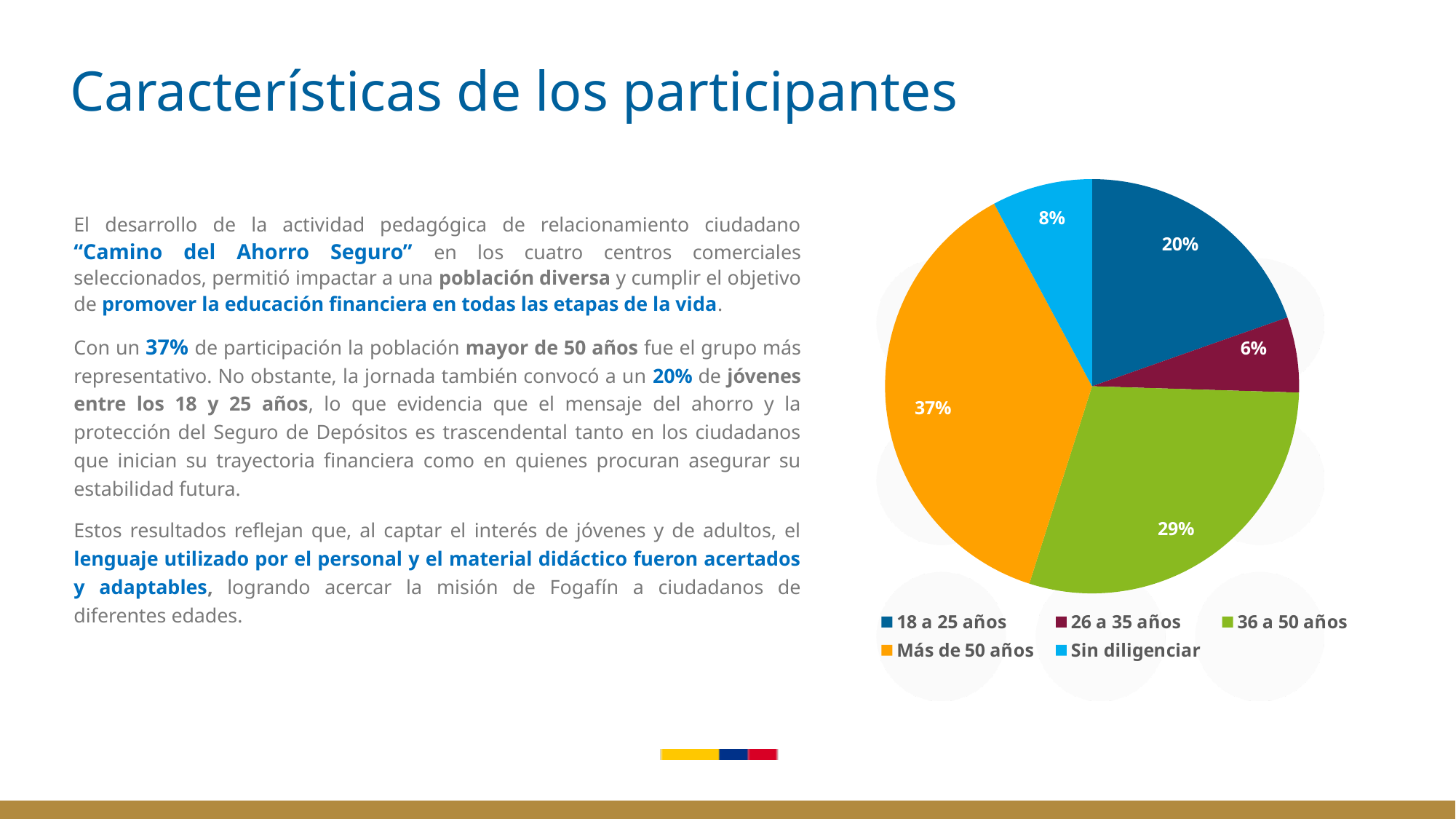
Which age group has the smallest share of the pie? 26 a 35 años What share of participants were Más de 50 años? 37% What share of participants is labelled Sin diligenciar? 8% Which slice is larger: 18 a 25 años or Sin diligenciar? 18 a 25 años How many slices does the pie chart have? 5 What share of participants were aged 36 a 50 años? 29% What colour is the slice for Más de 50 años? orange What is the difference in percentage points between the Más de 50 años slice and the 36 a 50 años slice? 8 What share of participants were aged 18 a 25 años? 20% What kind of chart is shown on the slide? pie chart Which age group has the largest share of the pie? Más de 50 años What share of participants were aged 26 a 35 años? 6%